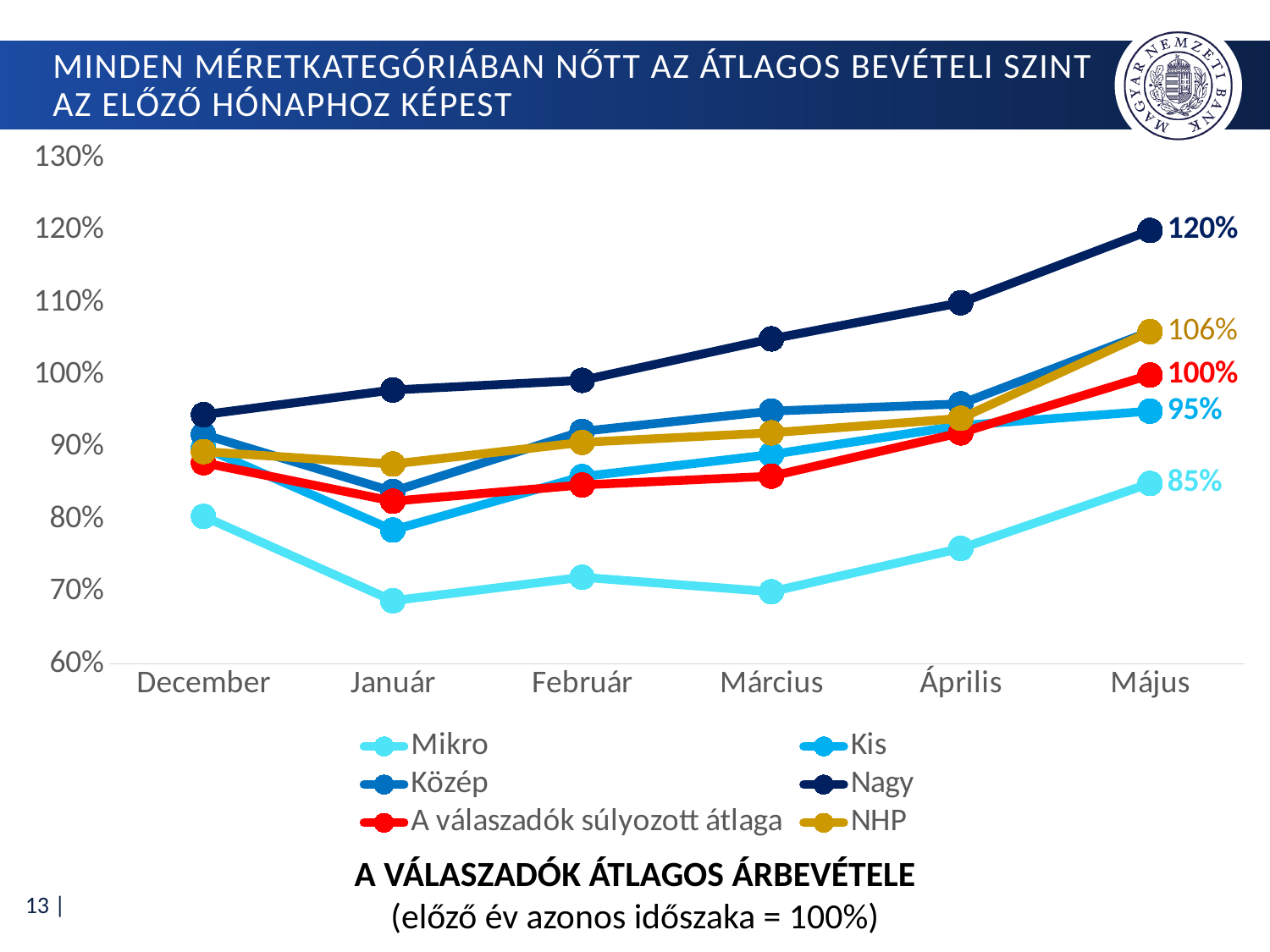
What is the value for Nagy in Május? 120% How many series does the legend list? 6 Which series has the lowest value in Május? Mikro Is the value for Nagy in Április greater or less than 100%? greater Is the value for Mikro in Január greater or less than 70%? less Which is larger in Május, the value for Kis or the value for Mikro? Kis What is the value for Kis in Május? 95% What is the value for Mikro in Május? 85% Which series has the highest value in Május? Nagy What is the difference between the Nagy and Mikro values in Május? 35 percentage points What kind of chart is shown on the slide? line chart What is the value for A válaszadók súlyozott átlaga in Május? 100%